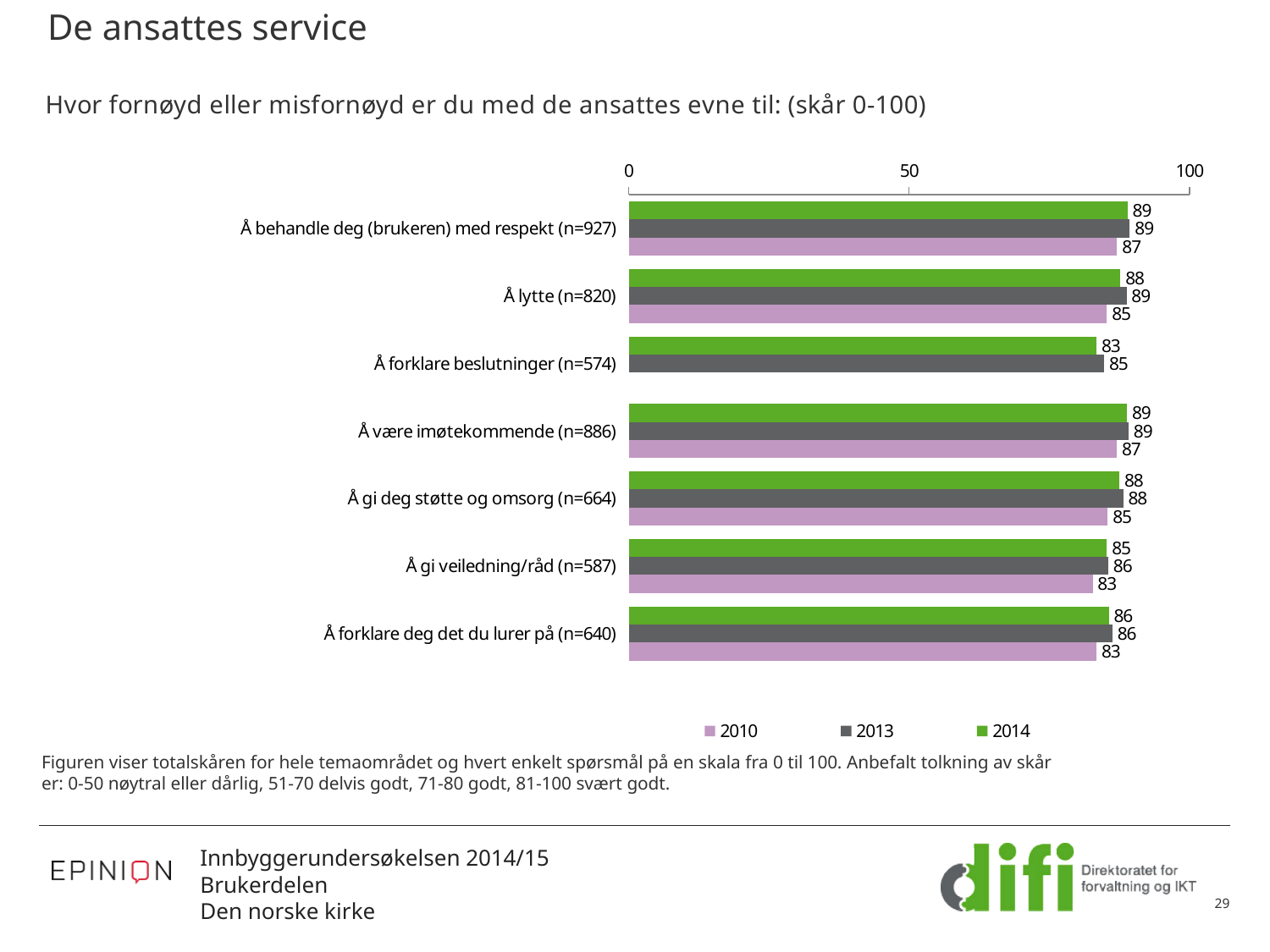
What is the 2010 value for "Å gi veiledning/råd (n=587)"? 83 Which series is shown in green in the legend? 2014 What kind of chart is shown on the slide? Bar chart What is the 2010 value for "Å behandle deg (brukeren) med respekt (n=927)"? 87 Which is larger for "Å gi veiledning/råd (n=587)": the 2013 value or the 2010 value? 2013 Which category has the lowest 2013 value? Å forklare beslutninger (n=574) Which category has the lowest 2014 value? Å forklare beslutninger (n=574) What is the difference between the 2013 and 2010 values for "Å lytte (n=820)"? 4 What is the 2014 value for "Å lytte (n=820)"? 88 What is the 2013 value for "Å forklare beslutninger (n=574)"? 85 How many categories are shown on the chart? 7 How many series does the legend list? 3